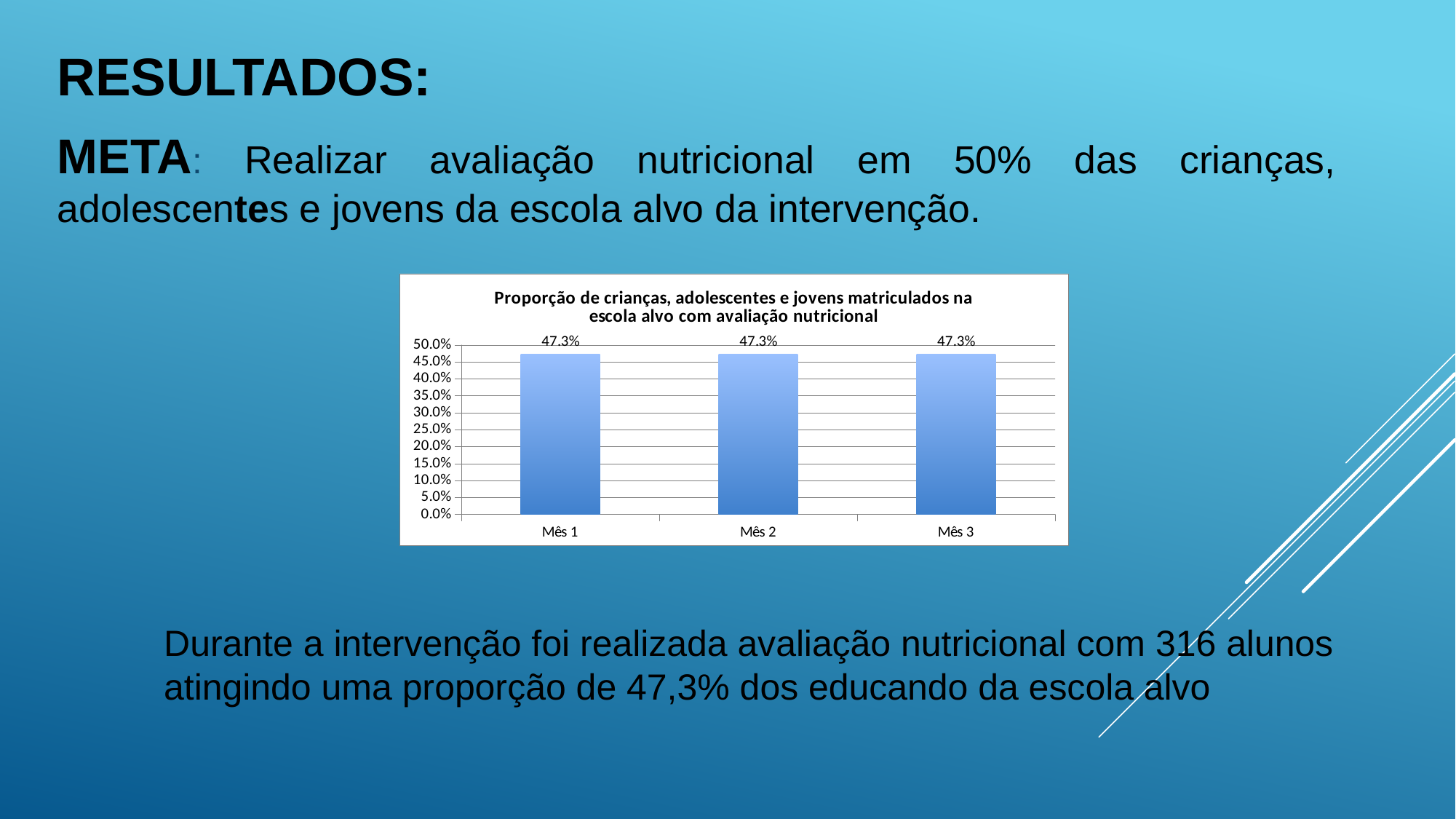
How many categories are shown on the x axis? 3 Do the values rise, fall or stay the same from Mês 1 to Mês 3? stay the same What is the difference between the values for Mês 1 and Mês 3? 0.0% What is the value for Mês 1? 47.3% Is the value for Mês 1 greater or less than 40.0%? greater What is the highest value shown on the y axis? 50.0% What kind of chart is shown on the slide? bar chart What is the value for Mês 2? 47.3% Is the value for Mês 2 greater or less than 50.0%? less What is the title of the chart? Proporção de crianças, adolescentes e jovens matriculados na escola alvo com avaliação nutricional What is the value for Mês 3? 47.3%